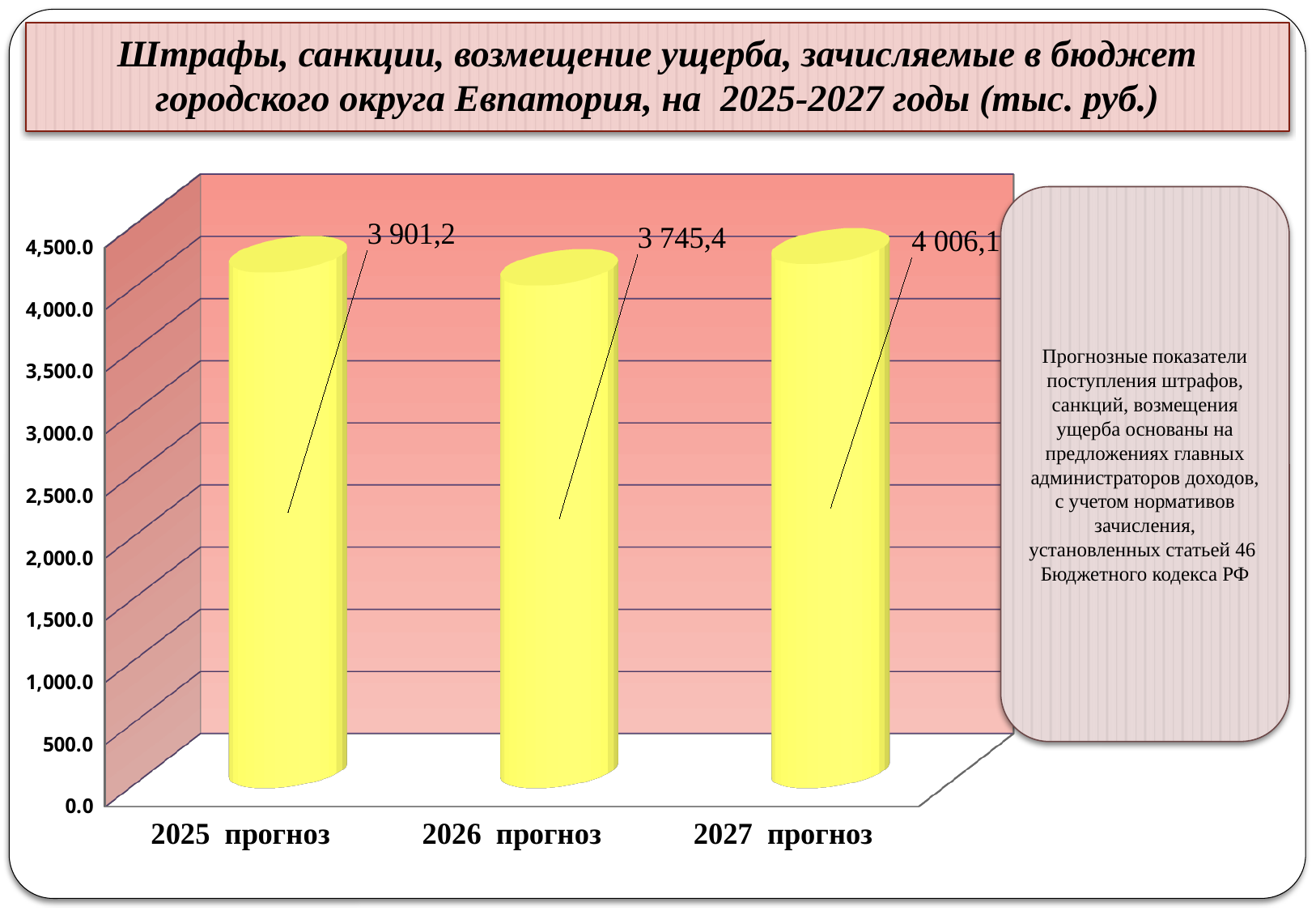
Which year has the lowest value? 2026 прогноз What kind of chart is shown on the slide? bar chart What is the difference between the values for 2025 прогноз and 2026 прогноз? 155,8 What is the value for 2025 прогноз? 3 901,2 Which is larger, the value for 2025 прогноз or 2026 прогноз? 2025 прогноз What is the difference between the values for 2027 прогноз and 2025 прогноз? 104,9 Is the value for 2026 прогноз greater or less than 3,500.0? greater How many categories are shown on the x axis? 3 Which year has the highest value? 2027 прогноз What is the value for 2027 прогноз? 4 006,1 What is the value for 2026 прогноз? 3 745,4 Does the value rise or fall from 2026 прогноз to 2027 прогноз? rise